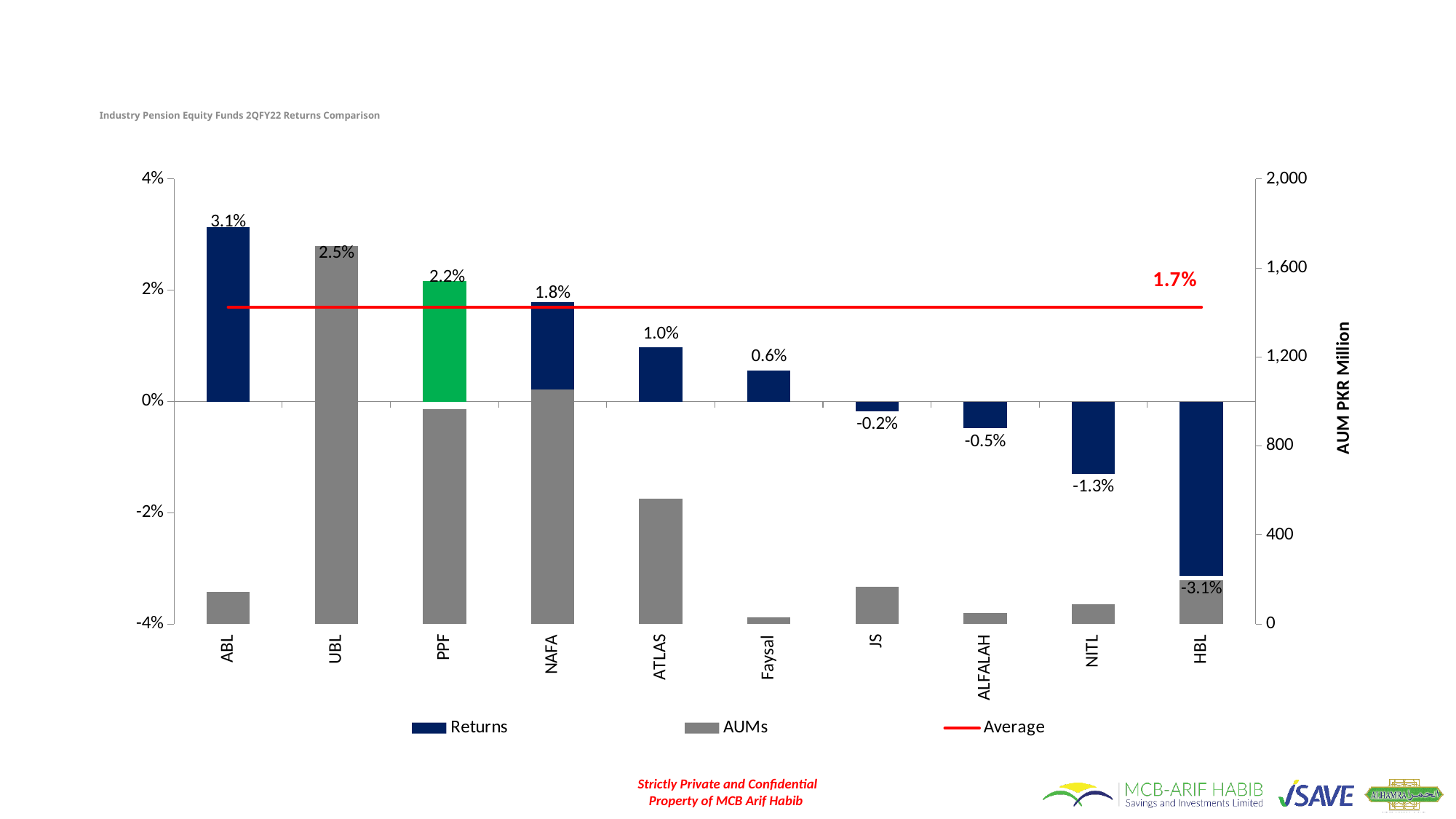
What is the difference between the returns of ABL and PPF? 0.9% Which fund has the lowest return? HBL What is the return for ABL? 3.1% Which fund has the highest return? ABL How many series does the legend list? 3 What is the return for Faysal? 0.6% Is the AUM for UBL greater or less than 1,600 PKR Million? greater What is the average return shown by the red line? 1.7% Is the AUM for HBL greater or less than 400 PKR Million? less Which has the larger return, ATLAS or ALFALAH? ATLAS How many funds are shown on the x axis? 10 What is the return for NITL? -1.3%